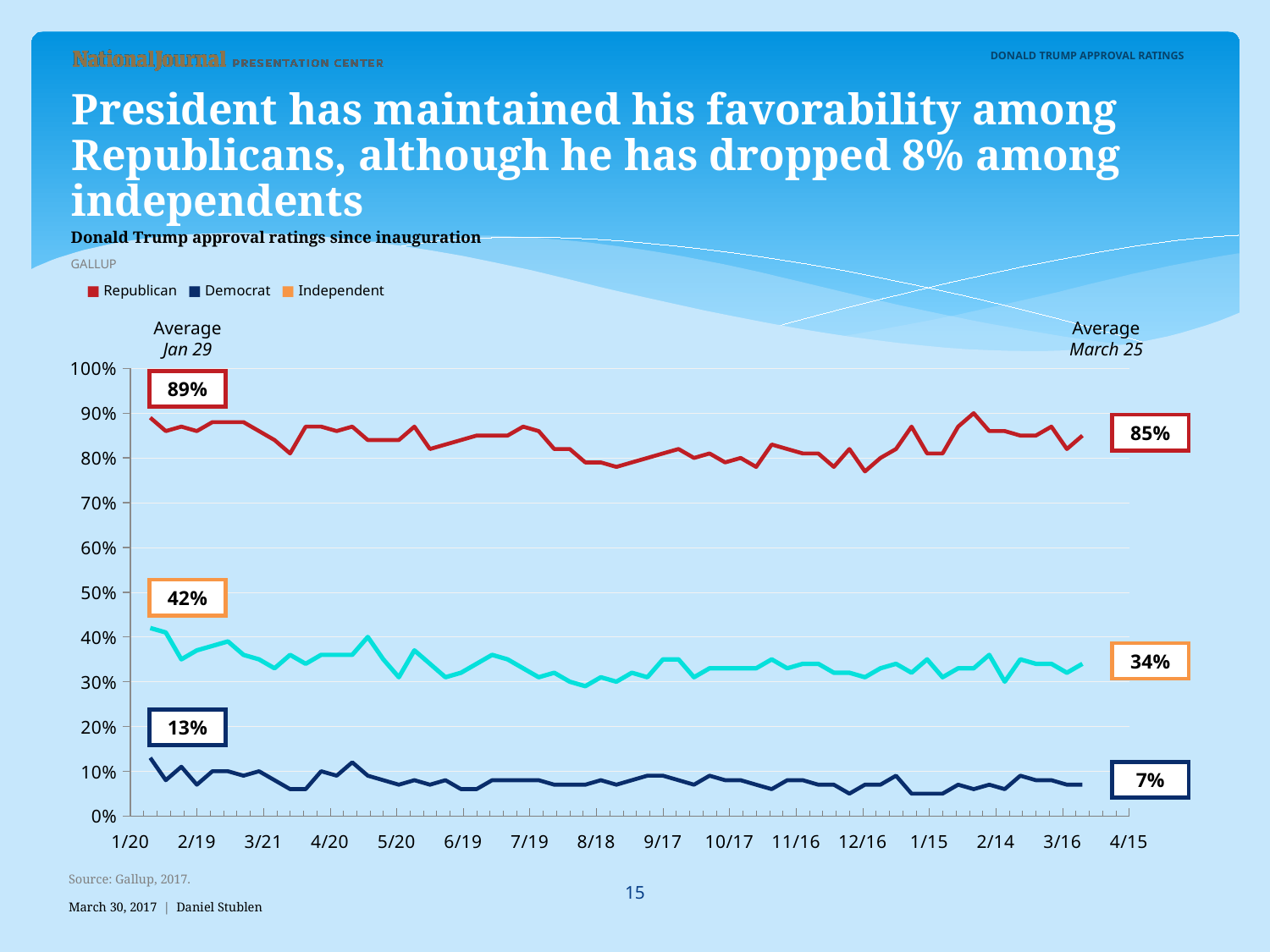
Which group has the lowest approval rating throughout the chart? Democrat What was the Republican average approval rating on Jan 29? 89% What was the Republican average approval rating on March 25? 85% Which group has the highest approval rating throughout the chart? Republican By how many percentage points did the Democrat average fall from Jan 29 to March 25? 6 What kind of chart is shown on the slide? line chart What was the Democrat average approval rating on Jan 29? 13% What is the source of the data shown in the chart? Gallup, 2017 What was the Independent average approval rating on March 25? 34% How many series does the legend list? 3 Does the Independent approval line generally rise or fall from Jan 29 to March 25? fall By how many percentage points did the Independent average fall from Jan 29 (42%) to March 25 (34%)? 8